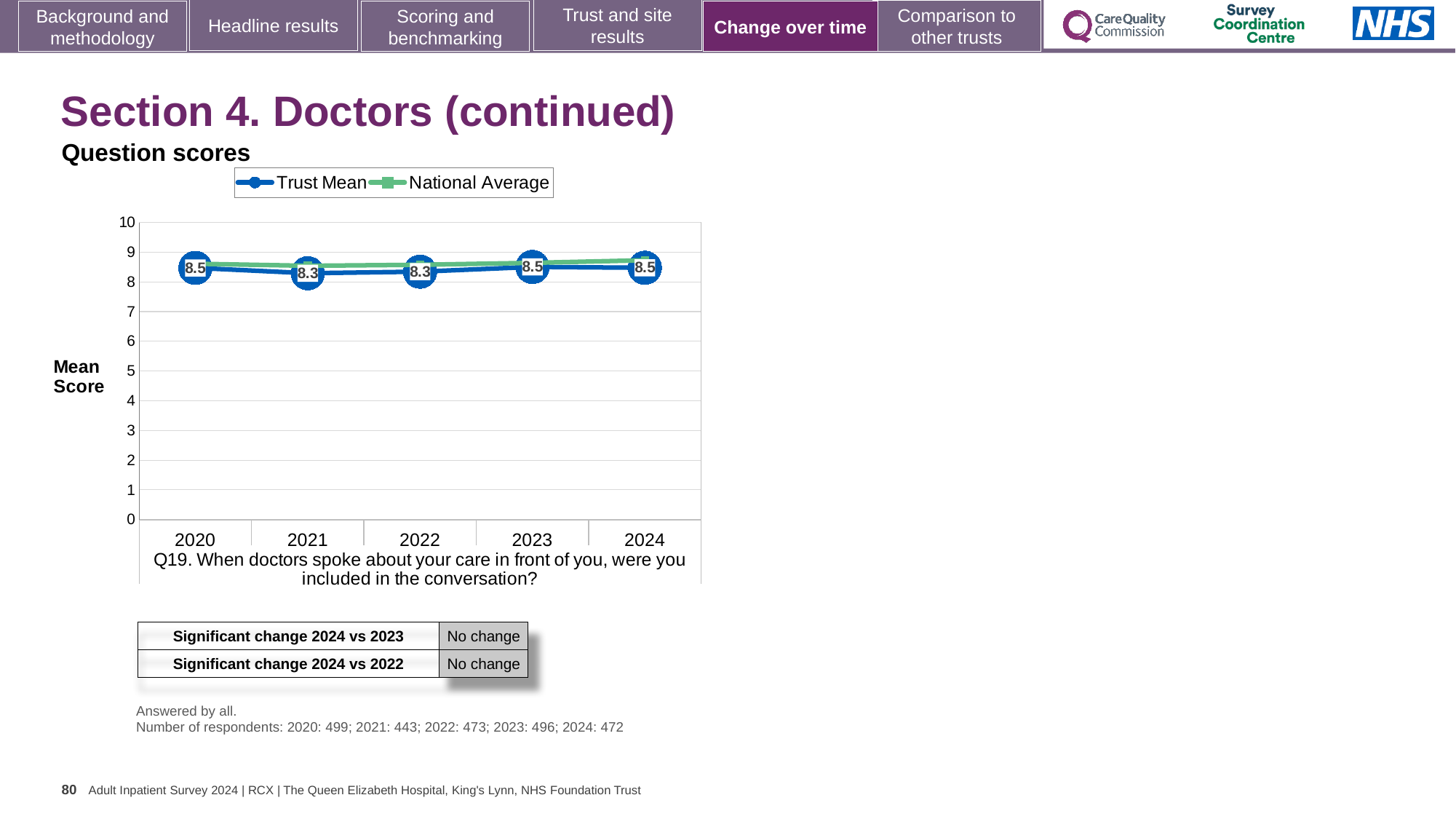
What kind of chart is shown on the slide? line chart How many series does the chart legend list? 2 Is the Trust Mean value for 2021 greater or less than 9? less Is the National Average value for 2024 greater or less than 8? greater What is the difference between the Trust Mean score in 2023 and in 2021? 0.2 Which question does the chart show scores for? Q19. When doctors spoke about your care in front of you, were you included in the conversation? How many years are shown on the x axis of the chart? 5 What is the Trust Mean score for 2021? 8.3 What is the Trust Mean score for 2024? 8.5 What is the Trust Mean score for 2020? 8.5 Is the Trust Mean score for 2023 larger or smaller than the Trust Mean score for 2022? larger What is the Trust Mean score for 2022? 8.3